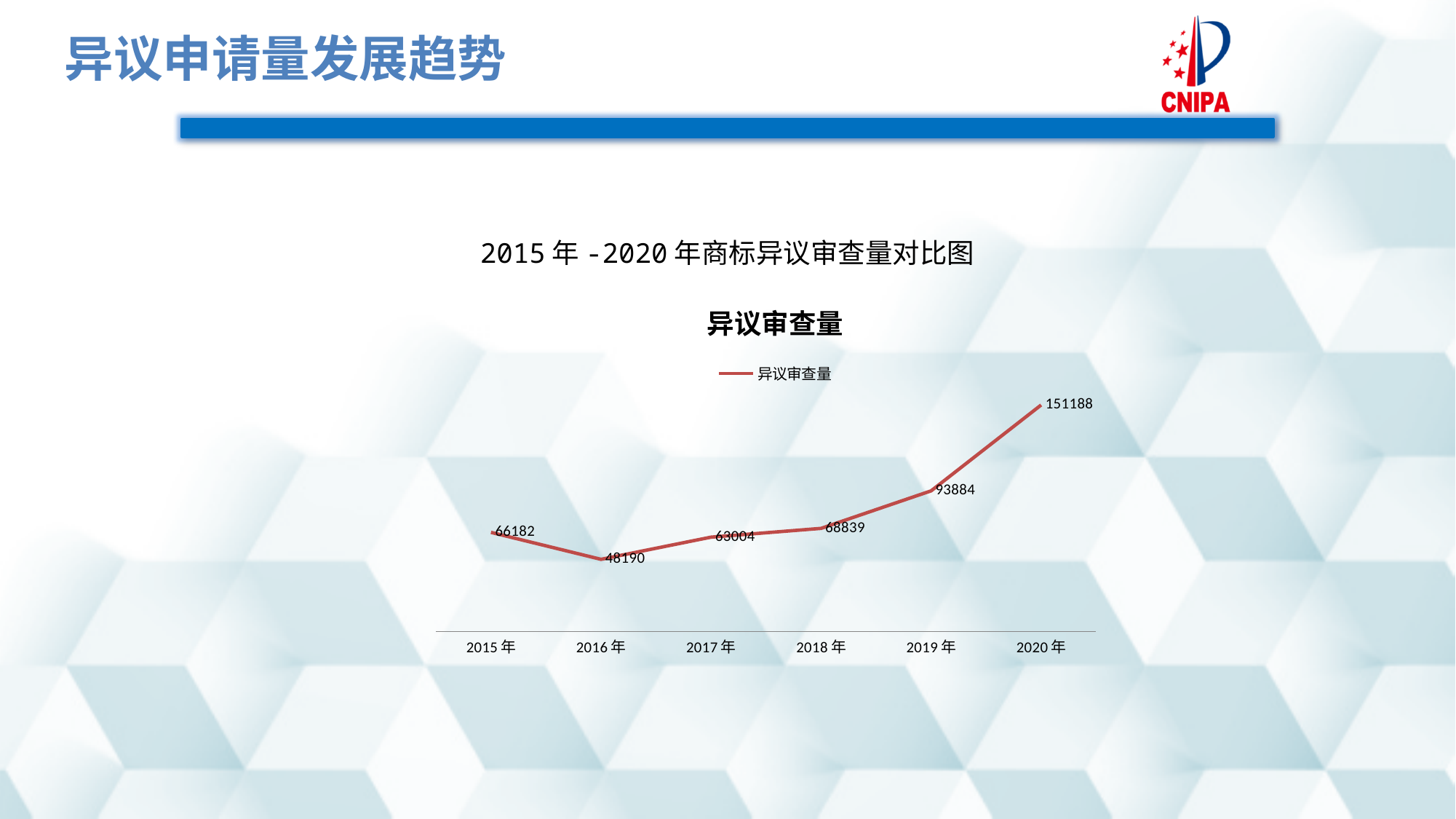
What kind of chart is shown on the slide? line chart What is the title of the chart? 异议审查量 What is the value for 2015年 in the 异议审查量 chart? 66182 What is the value for 2020年 in the 异议审查量 chart? 151188 What is the difference between the 2020年 and 2019年 values? 57304 What is the value for 2016年 in the 异议审查量 chart? 48190 Which year has the highest 异议审查量? 2020年 Which is larger, the value for 2017年 or the value for 2018年? 2018年 How many years are plotted on the x axis? 6 What is the value for 2018年 in the 异议审查量 chart? 68839 What is the difference between the 2015年 and 2016年 values? 17992 Which year has the lowest 异议审查量? 2016年